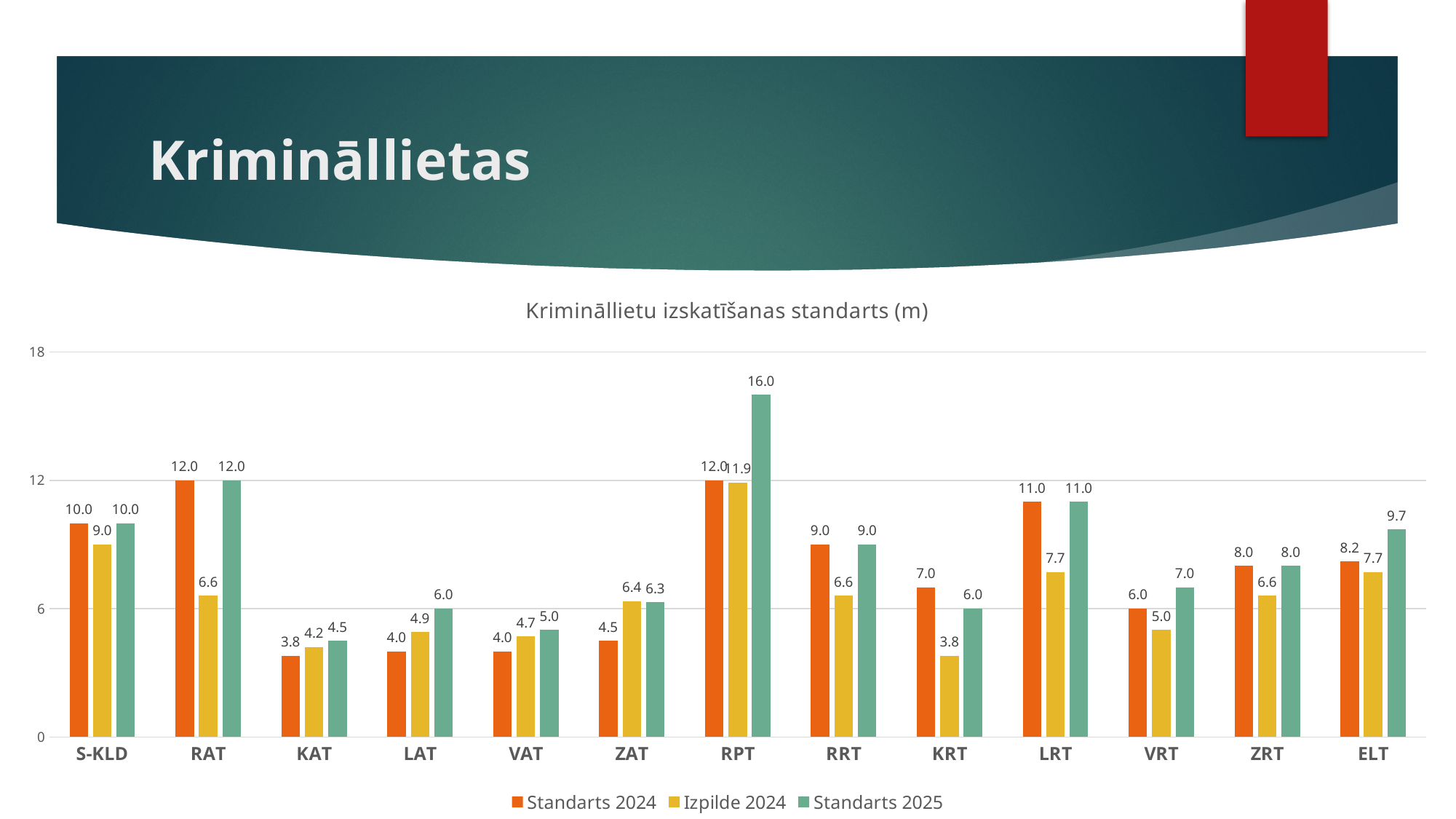
How many categories are shown on the x axis? 13 Is the Standarts 2025 value for LRT greater or less than 6? greater What kind of chart is shown on the slide? Bar chart What is the title of the chart? Krimināllietu izskatīšanas standarts (m) What is the difference between the Standarts 2025 and Izpilde 2024 values for RAT? 5.4 Which category has the highest Standarts 2025 value? RPT What is the Izpilde 2024 value for KRT? 3.8 Which is larger for LAT: the Izpilde 2024 value or the Standarts 2025 value? Standarts 2025 What is the Standarts 2024 value for ELT? 8.2 Which category has the lowest Standarts 2024 value? KAT What is the Standarts 2025 value for RPT? 16.0 How many series does the legend list? 3